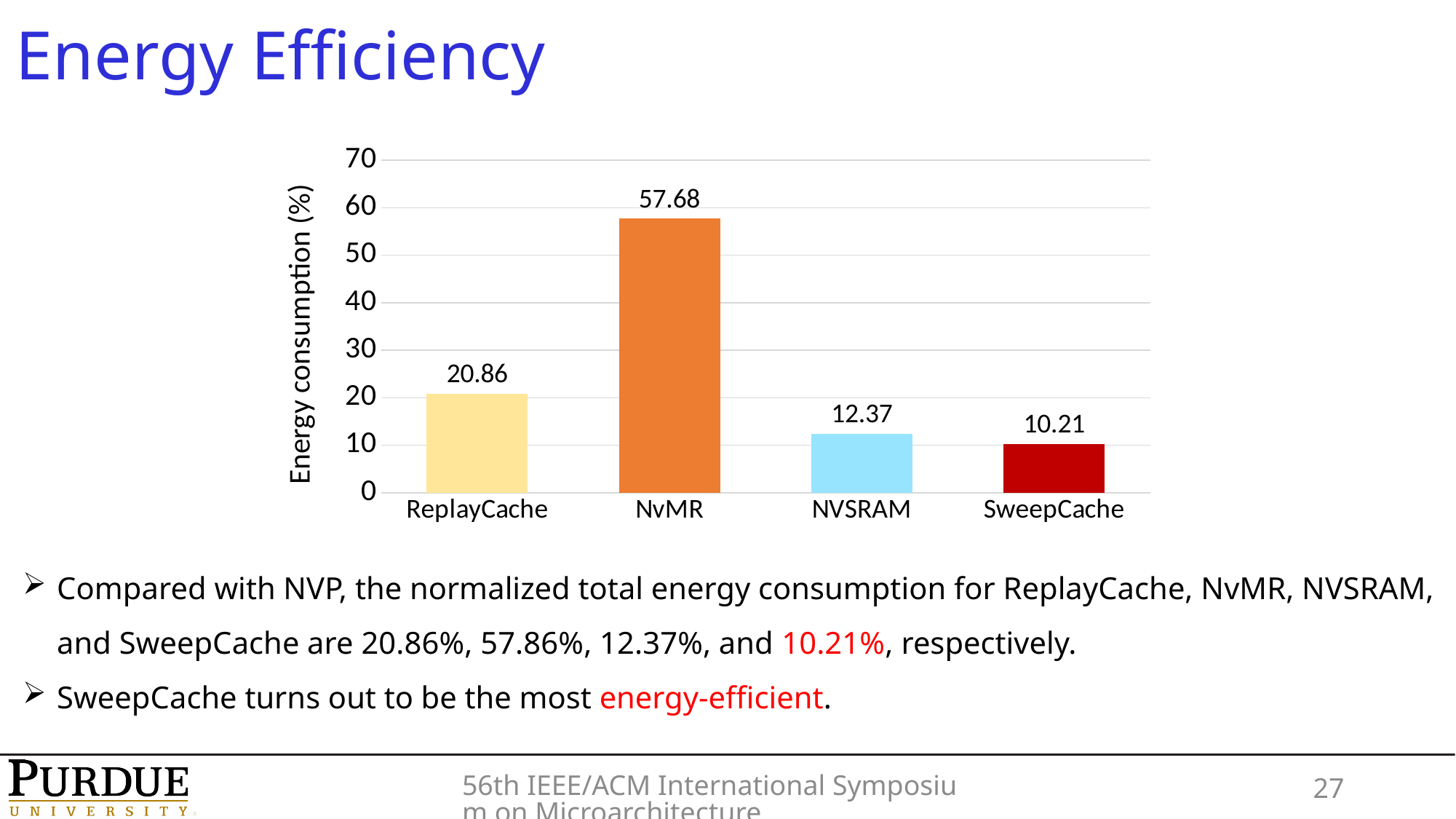
What is the energy consumption value for SweepCache? 10.21 Which has a larger energy consumption, ReplayCache or NVSRAM? ReplayCache What is the energy consumption value for NvMR? 57.68 What is the energy consumption value for NVSRAM? 12.37 What is the label of the y axis of the chart? Energy consumption (%) How many categories are shown on the x axis of the chart? 4 What is the energy consumption value for ReplayCache? 20.86 What is the difference between the energy consumption of NvMR and ReplayCache? 36.82 Which category has the highest energy consumption? NvMR Which category has the lowest energy consumption? SweepCache What kind of chart is shown on the slide? bar chart What is the difference between the energy consumption of NVSRAM and SweepCache? 2.16